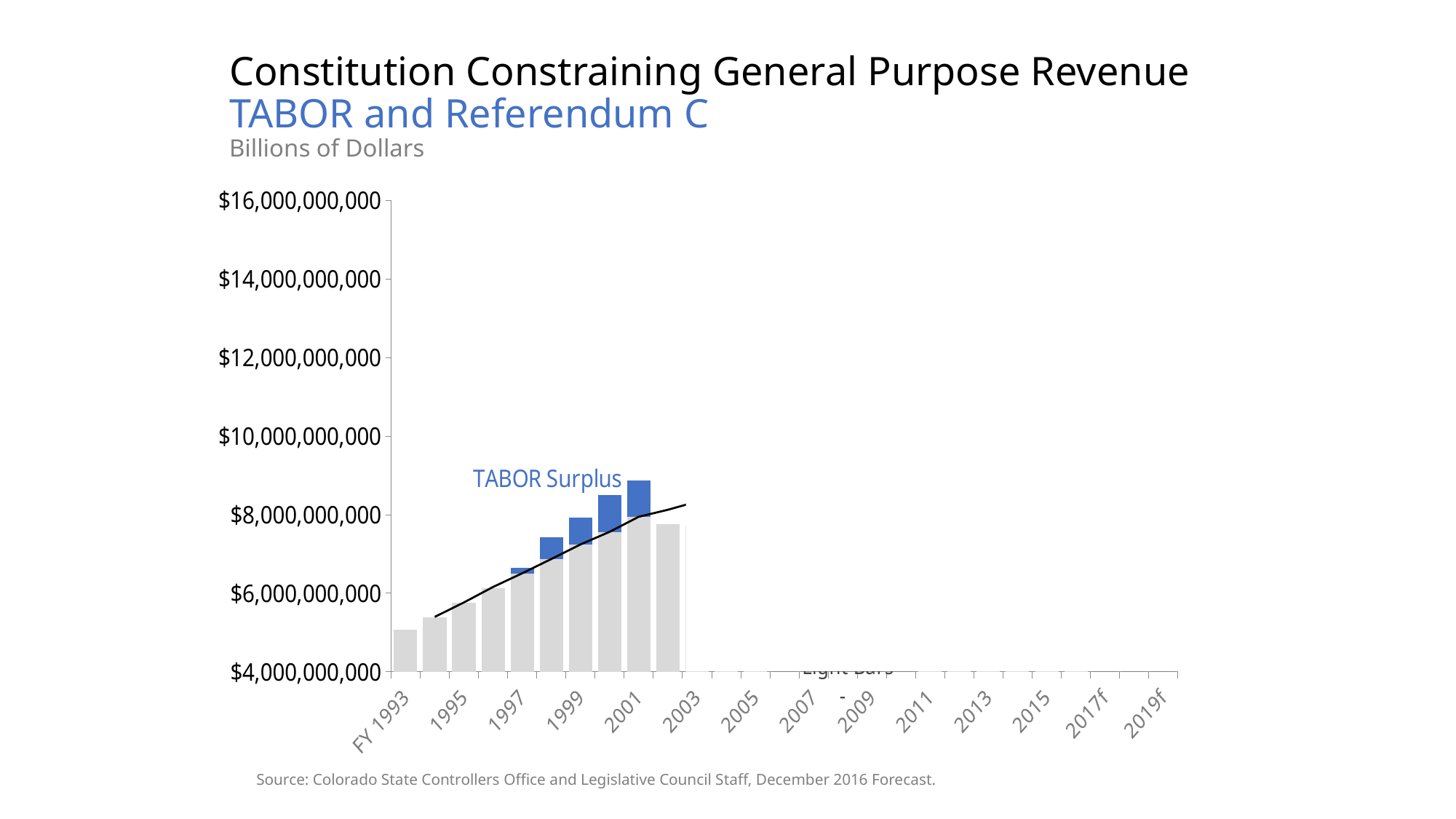
What kind of chart is shown on the slide? bar and line chart What unit does the chart say its values are in? Billions of Dollars Which year has the lowest bar on the chart? FY 1993 Is the total height of the bar for 1999, including the TABOR Surplus, greater or less than $6,000,000,000? greater What is the main title of the chart on the slide? Constitution Constraining General Purpose Revenue How many blue TABOR Surplus segments are shown on the chart? 5 Is the value for 1995 greater or less than $6,000,000,000? less Which year has the tallest bar on the chart, including the TABOR Surplus portion? 2001 Which is taller, the bar for FY 1993 or the bar for 1997 including the TABOR Surplus? 1997 Is the value for FY 1993 greater or less than $6,000,000,000? less Do the bar values rise or fall from FY 1993 to 2001? rise